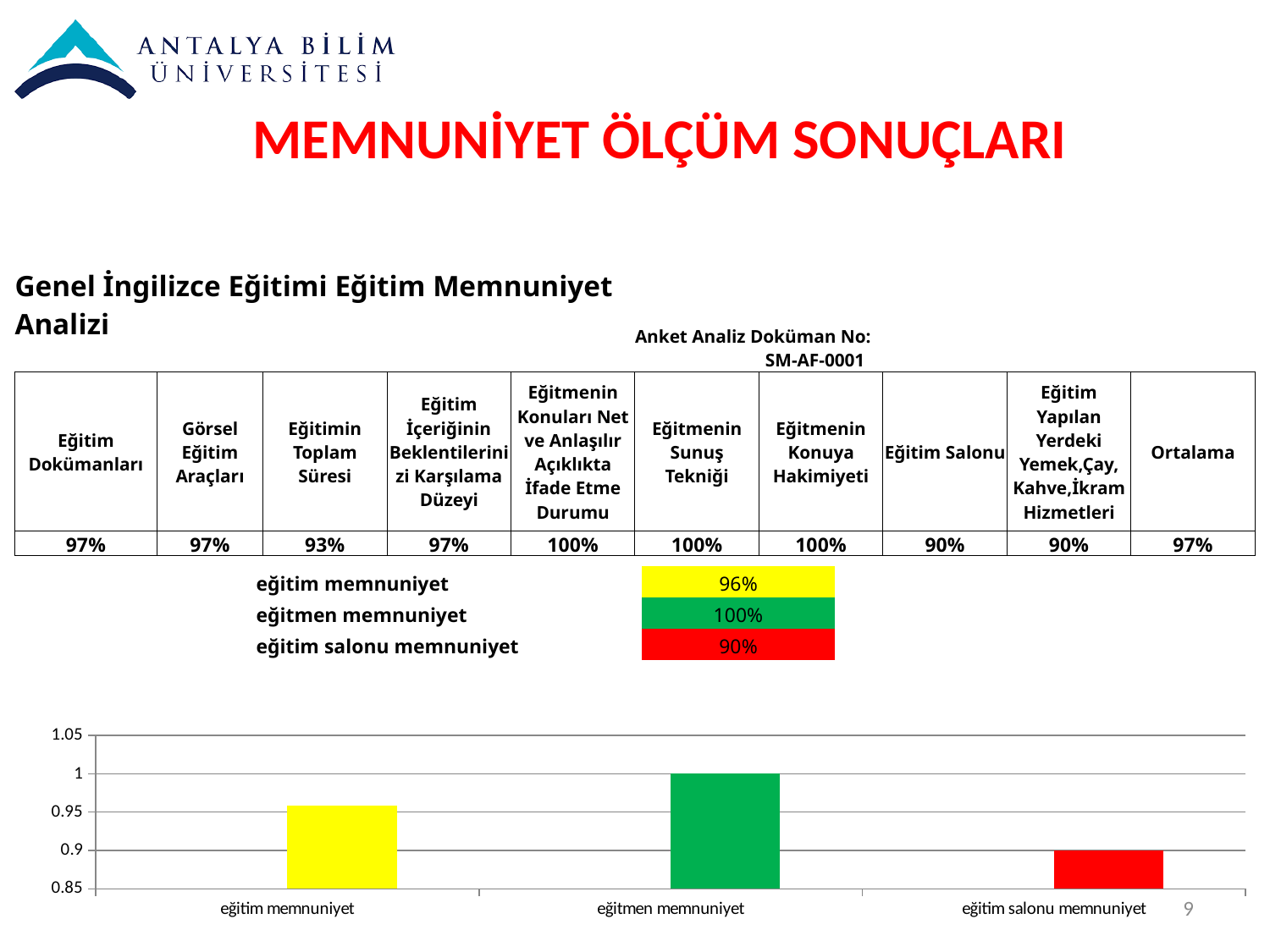
Which category has the highest bar in the chart? eğitmen memnuniyet What is the difference between the values for eğitmen memnuniyet and eğitim salonu memnuniyet? 0.1 Which category has the lowest bar in the chart? eğitim salonu memnuniyet What colour is the bar for eğitmen memnuniyet? green Is the value for eğitim memnuniyet greater or less than 0.95? greater What kind of chart is shown at the bottom of the slide? bar chart Does the value fall or rise from eğitmen memnuniyet to eğitim salonu memnuniyet? fall What is the highest tick value shown on the y axis of the chart? 1.05 What value does the bar for eğitim salonu memnuniyet reach on the y axis? 0.9 How many categories are plotted in the bar chart? 3 Which is larger in the chart: eğitim memnuniyet or eğitim salonu memnuniyet? eğitim memnuniyet What value does the bar for eğitmen memnuniyet reach on the y axis? 1